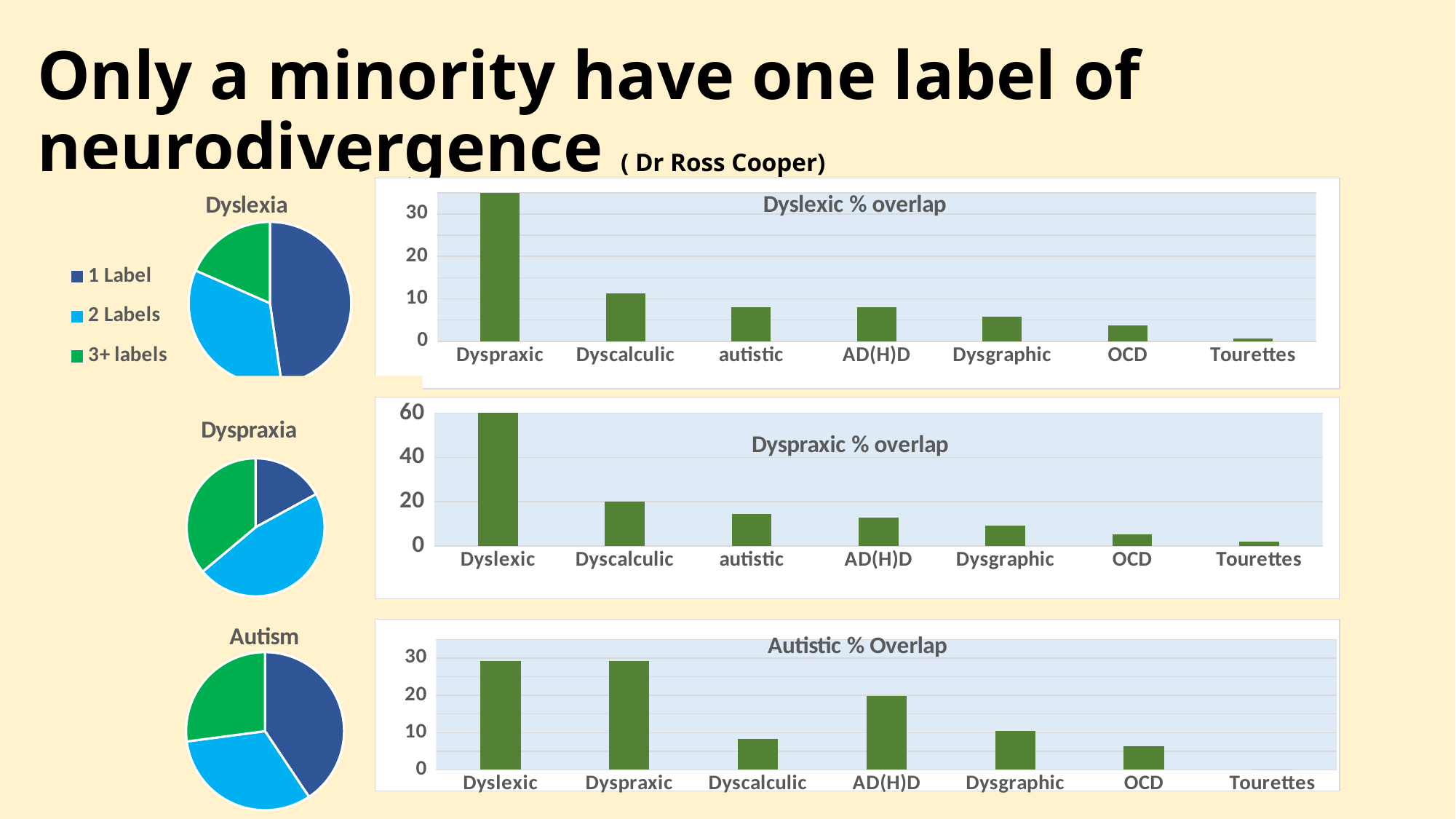
In the Dyspraxic % overlap chart, which category has the highest value? Dyslexic How many categories are shown on the x axis of the Dyspraxic % overlap chart? 7 In the Dyslexic % overlap chart, which category has the highest value? Dyspraxic In the Autistic % Overlap chart, which is larger, the value for AD(H)D or the value for Dyscalculic? AD(H)D In the Autistic % Overlap chart, is the value for OCD greater or less than 10? less In the Dyspraxic % overlap chart, is the value for autistic greater or less than 20? less In the Dyslexic % overlap chart, is the value for Dyspraxic greater or less than 30? greater In the Dyspraxia pie chart, which slice is the smallest? 1 Label How many entries does the legend for the pie charts list? 3 In the Dyslexic % overlap chart, which category has the lowest value? Tourettes